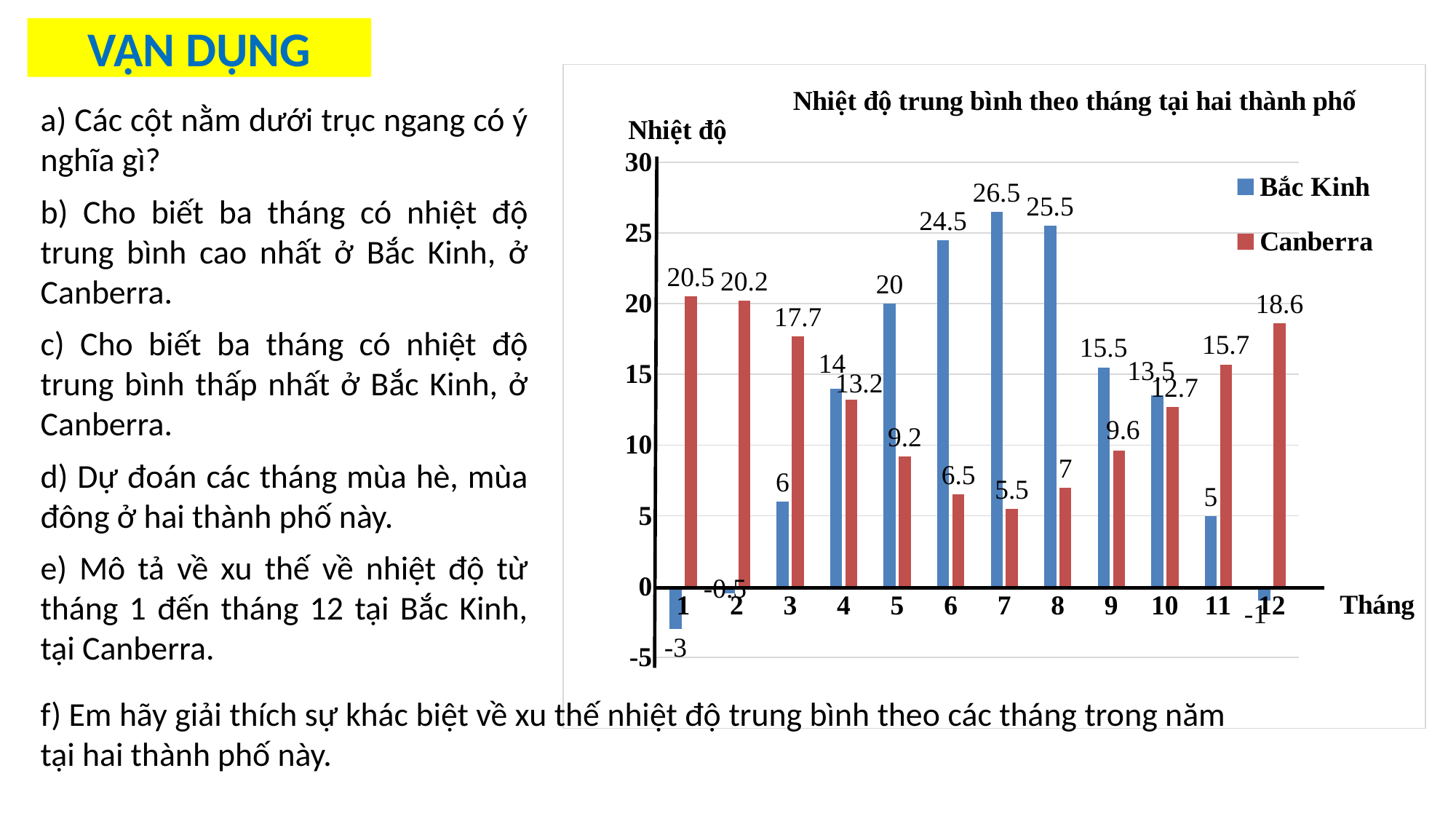
In which month is the Canberra value lowest? 7 What is the difference between the Bắc Kinh and Canberra values in month 7? 21 Is the value for Canberra in month 12 greater or less than 15? greater In which month is the Bắc Kinh value highest? 7 What is the value for Bắc Kinh in month 1? -3 What is the title of the chart? Nhiệt độ trung bình theo tháng tại hai thành phố How many series does the legend list? 2 What type of chart is shown on the slide? bar chart What is the average temperature for Canberra in month 1? 20.5 How many months are shown on the x axis? 12 In month 4, which city has the higher value, Bắc Kinh or Canberra? Bắc Kinh What is the average temperature for Bắc Kinh in month 7? 26.5